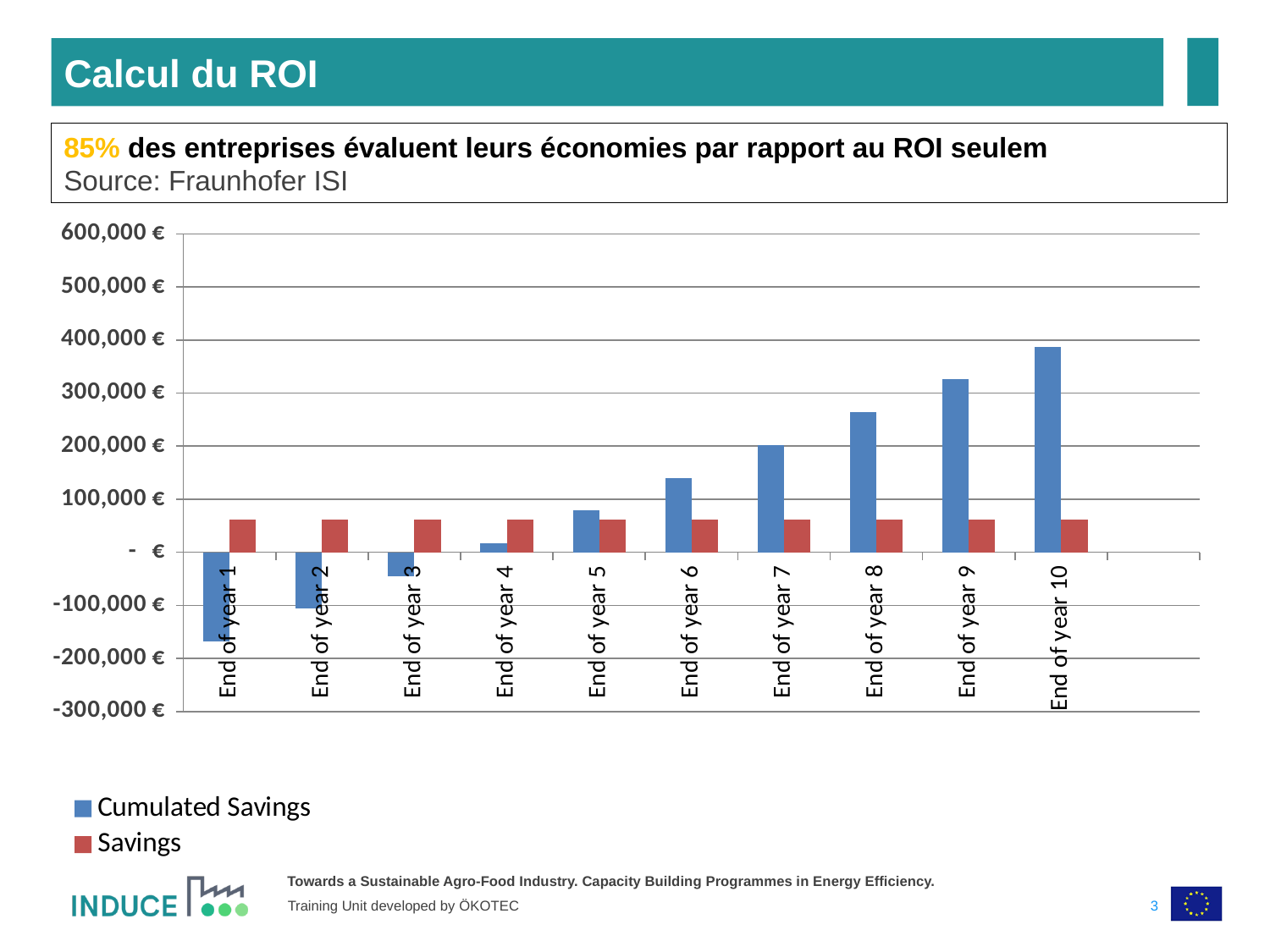
At End of year 6, which is larger: Cumulated Savings or Savings? Cumulated Savings Which colour represents the Savings series in the legend? Red How many categories are shown on the x axis? 10 Is the Cumulated Savings value for End of year 1 greater or less than -100,000 €? less What kind of chart is shown on the slide? Bar chart Is the Cumulated Savings value for End of year 10 greater or less than 300,000 €? greater Which category has the highest Cumulated Savings value? End of year 10 How many series does the legend list? 2 Do the Cumulated Savings values rise or fall from End of year 1 to End of year 10? Rise Which category has the lowest Cumulated Savings value? End of year 1 Is the Cumulated Savings value for End of year 6 greater or less than 100,000 €? greater